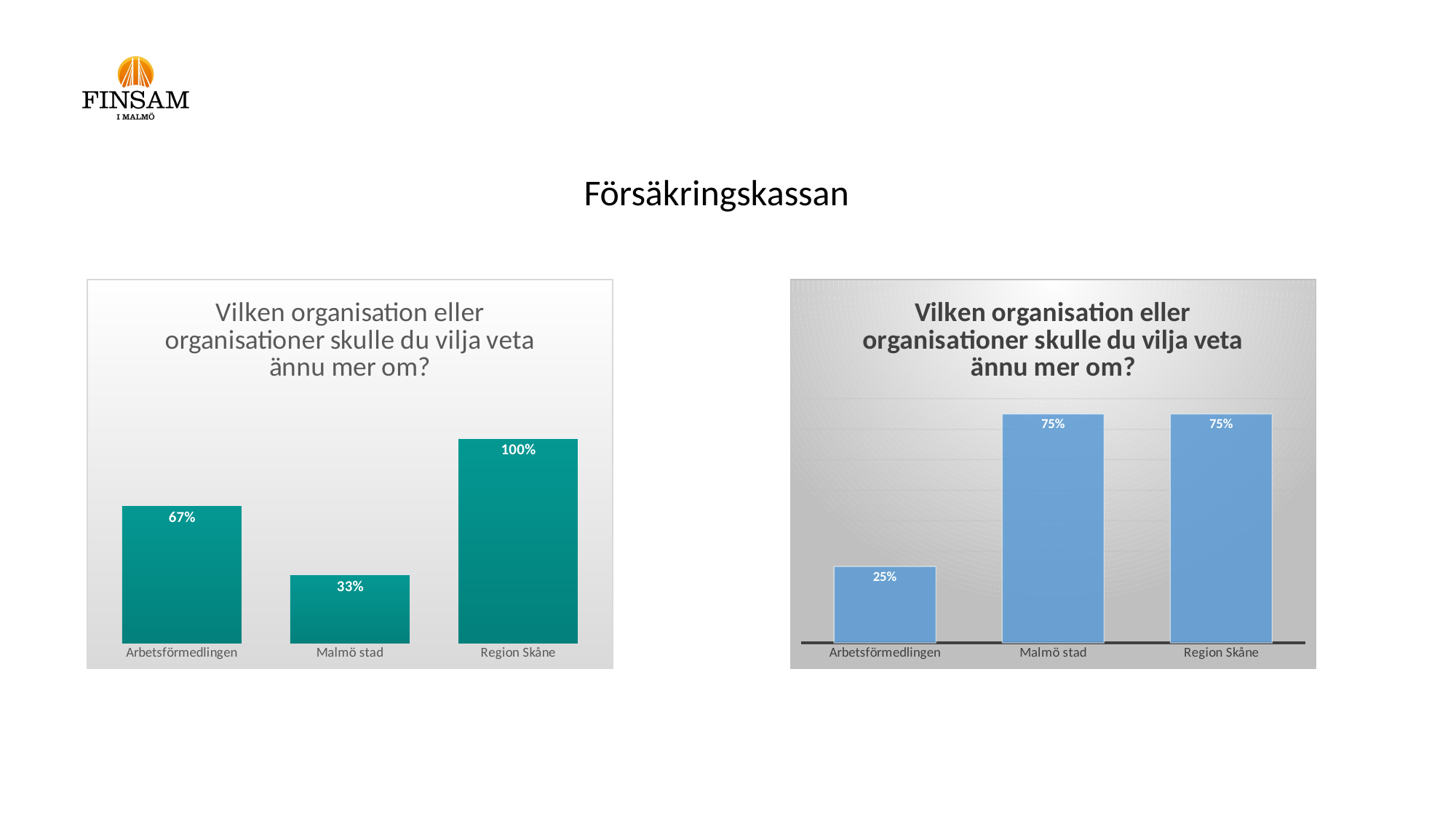
In the right chart, what is the difference between the values for Malmö stad and Arbetsförmedlingen? 50% In the left chart, what is the value for Region Skåne? 100% In the left chart, which category has the highest value? Region Skåne In the right chart, which category has the lowest value? Arbetsförmedlingen In the left chart, which category has the lowest value? Malmö stad What kind of chart is the left chart? Bar chart In the left chart, what is the value for Malmö stad? 33% In the left chart, which is larger: the value for Arbetsförmedlingen or the value for Malmö stad? Arbetsförmedlingen In the right chart, what is the value for Malmö stad? 75% In the right chart, what is the value for Arbetsförmedlingen? 25% How many categories does the right chart show? 3 In the left chart, what is the difference between the values for Region Skåne and Arbetsförmedlingen? 33%